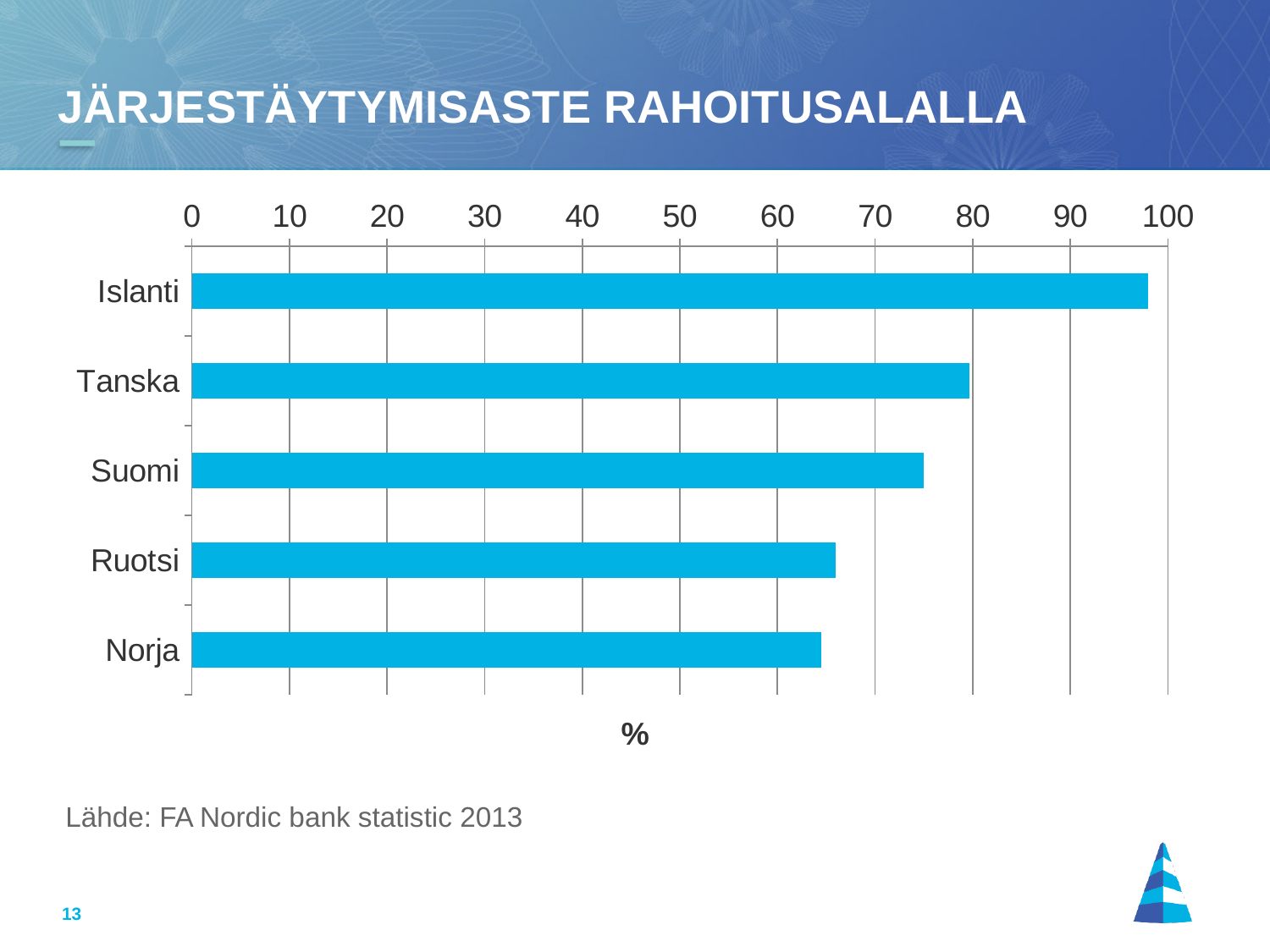
Which has the larger value, Tanska or Suomi? Tanska How many countries are shown in the chart? 5 What kind of chart is shown on the slide? bar chart Is the value for Ruotsi greater or less than 70? less Which country has the highest value in the chart? Islanti Do the bar values increase or decrease going from the top of the chart (Islanti) to the bottom (Norja)? decrease Is the value for Norja greater or less than 60? greater Is the value for Tanska greater or less than 70? greater Which has the larger value, Suomi or Ruotsi? Suomi What unit is shown on the horizontal axis label of the chart? %